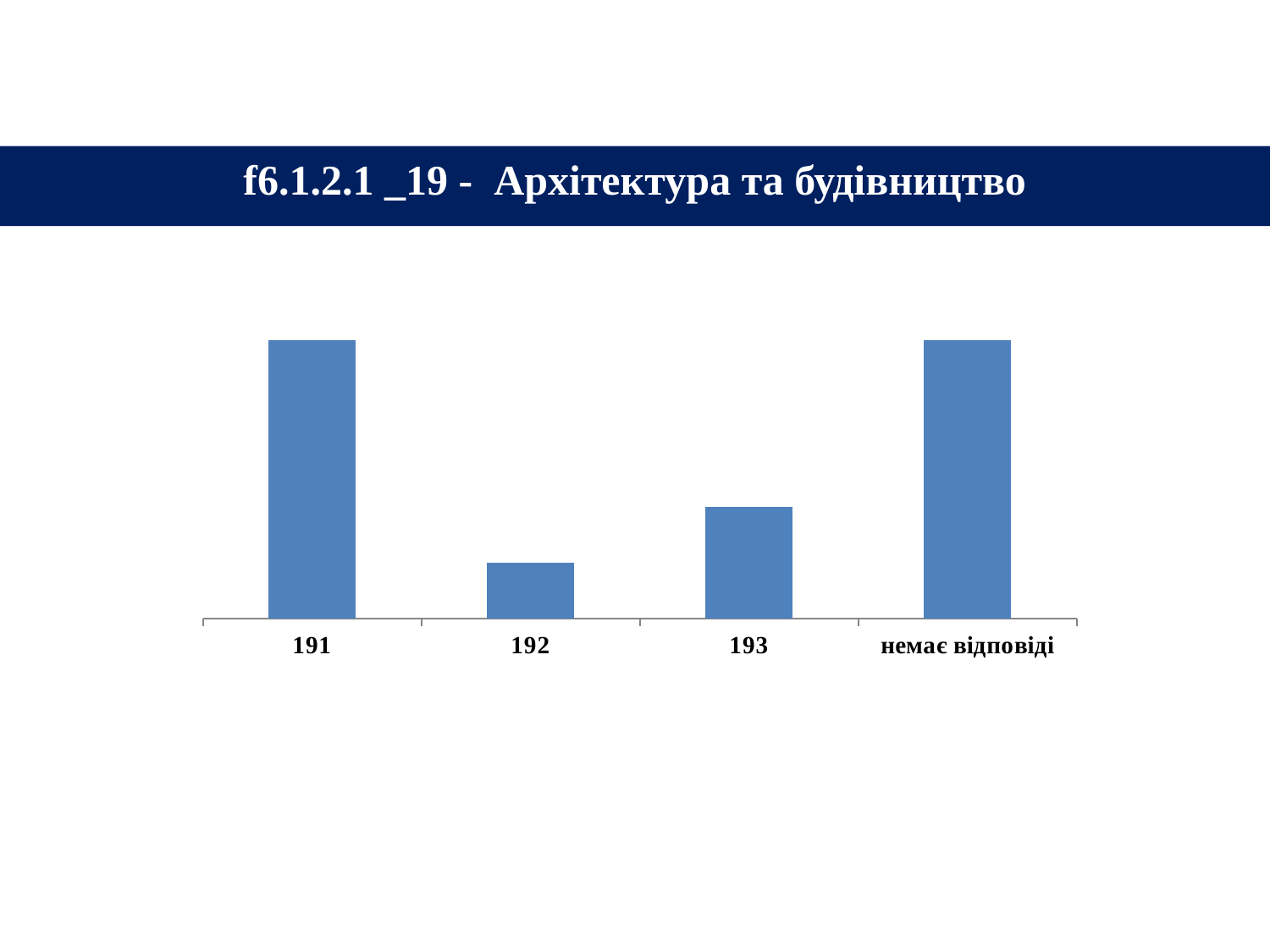
Which bar is taller, немає відповіді or 193? немає відповіді What is the label of the rightmost category on the x axis? немає відповіді Which category has the lowest bar in the chart? 192 Which bar is taller, 193 or 192? 193 What is the title of the slide above the chart? f6.1.2.1 _19 - Архітектура та будівництво How many categories are shown on the x axis of the chart? 4 What kind of chart is shown on the slide? bar chart Which bar is taller, 191 or 192? 191